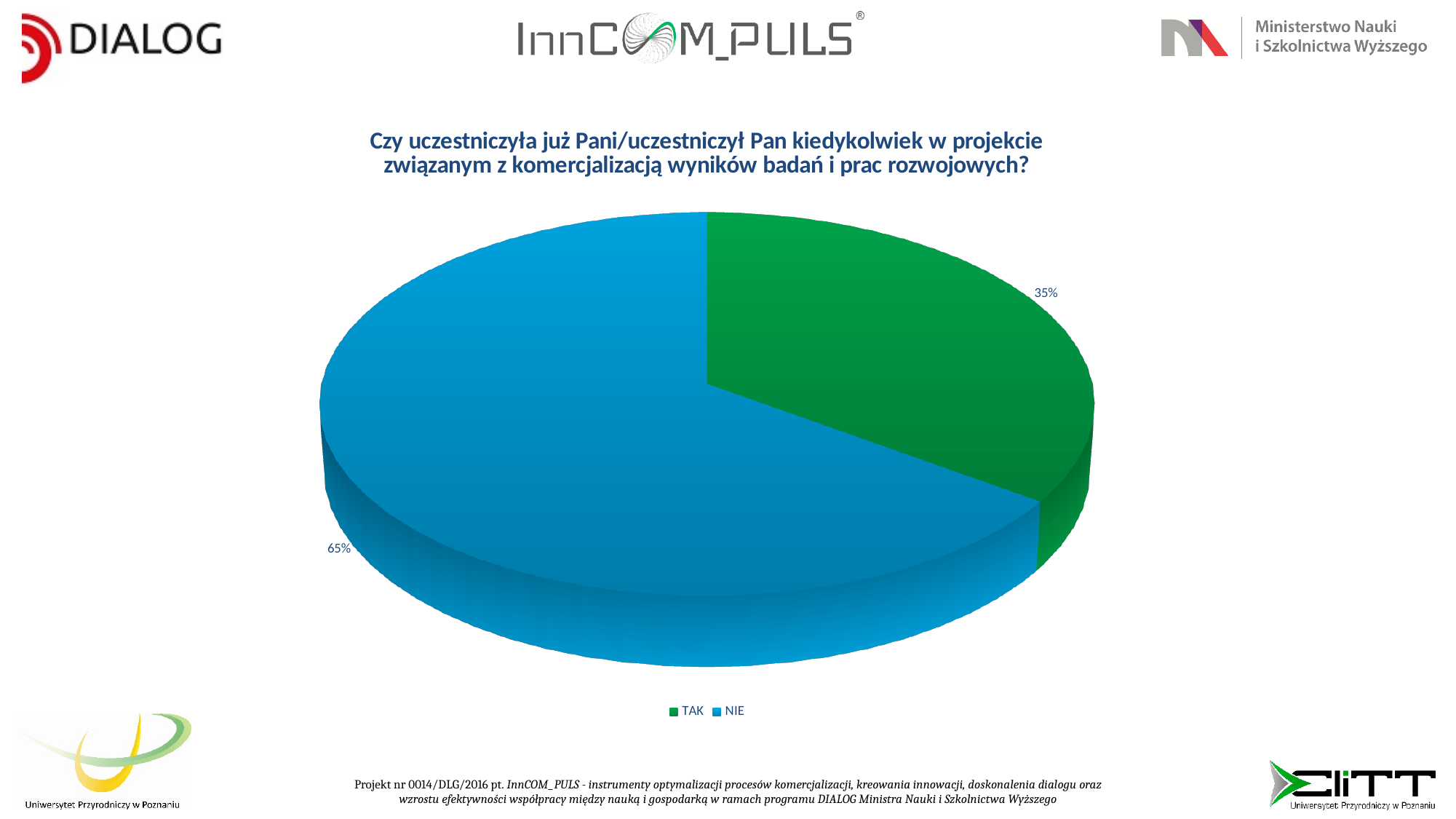
Which answer has the smallest share of the pie? TAK What colour is the TAK slice? green What colour is the NIE slice? blue What type of chart is shown on the slide? pie chart Which answer has the largest share of the pie? NIE Which slice is larger, TAK or NIE? NIE What share of the pie does the TAK slice represent? 35% How many entries does the legend list? 2 How many slices does the pie chart have? 2 What percentage of respondents answered NIE? 65% What is the difference in percentage points between the NIE and TAK slices? 30 What percentage of respondents answered TAK? 35%